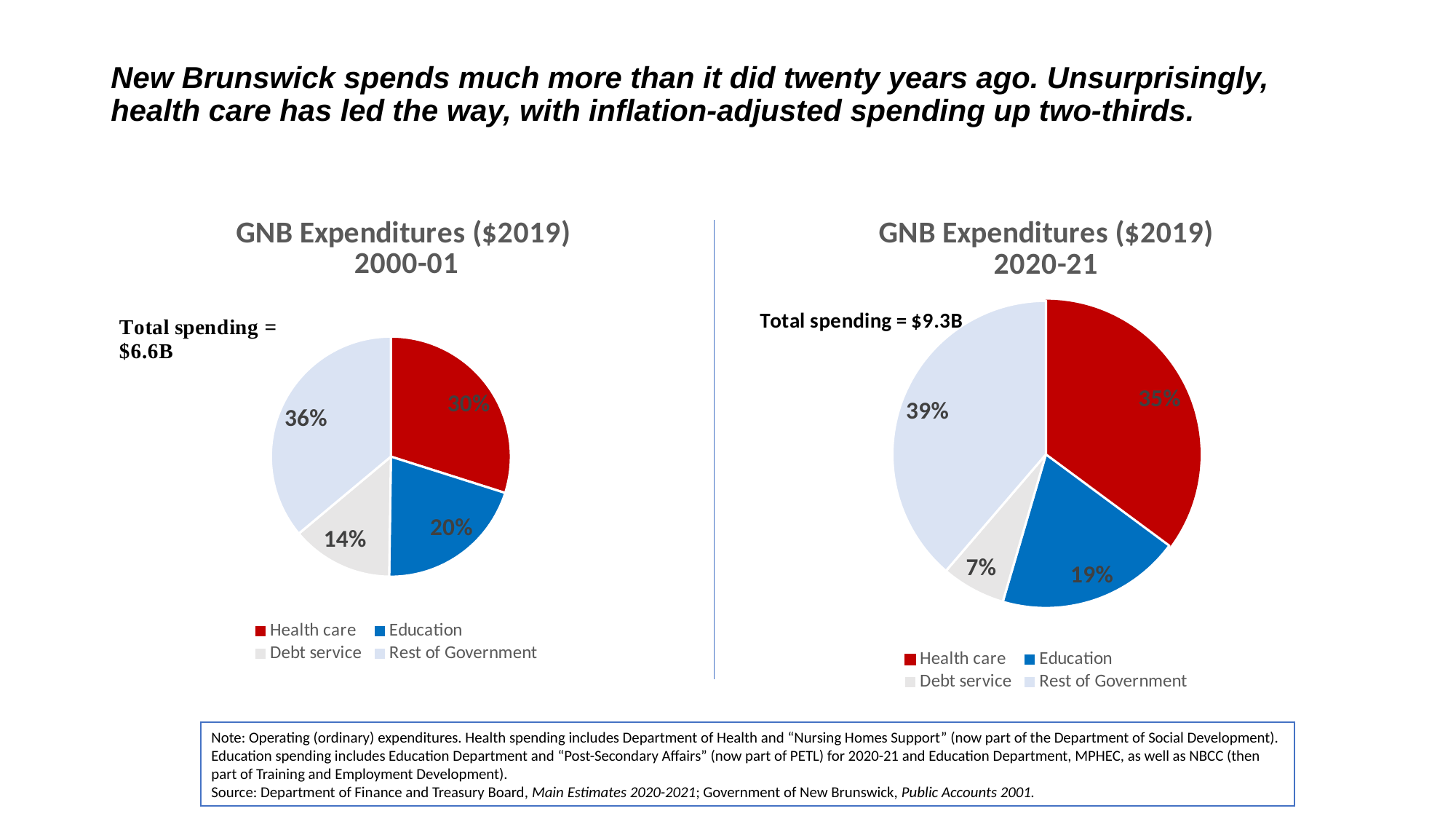
In the GNB Expenditures 2020-21 chart, what is the difference between the Health care share and the Education share? 16% What is the total spending shown for the GNB Expenditures 2020-21 chart? $9.3B In the GNB Expenditures 2020-21 chart, what share of spending is Health care? 35% In the GNB Expenditures 2020-21 chart, what share of spending is Debt service? 7% In the GNB Expenditures 2000-01 chart, what share of spending is Debt service? 14% Is the Education share larger in the 2000-01 chart or the 2020-21 chart? 2000-01 In the GNB Expenditures 2000-01 chart, which colour represents Education? Blue In the GNB Expenditures 2000-01 chart, what share of spending is Health care? 30% In the GNB Expenditures 2000-01 chart, which category has the smallest share? Debt service What kind of chart is the GNB Expenditures 2020-21 chart? Pie chart In the GNB Expenditures 2020-21 chart, which category has the largest share? Rest of Government How many categories does the GNB Expenditures 2000-01 pie chart show? 4